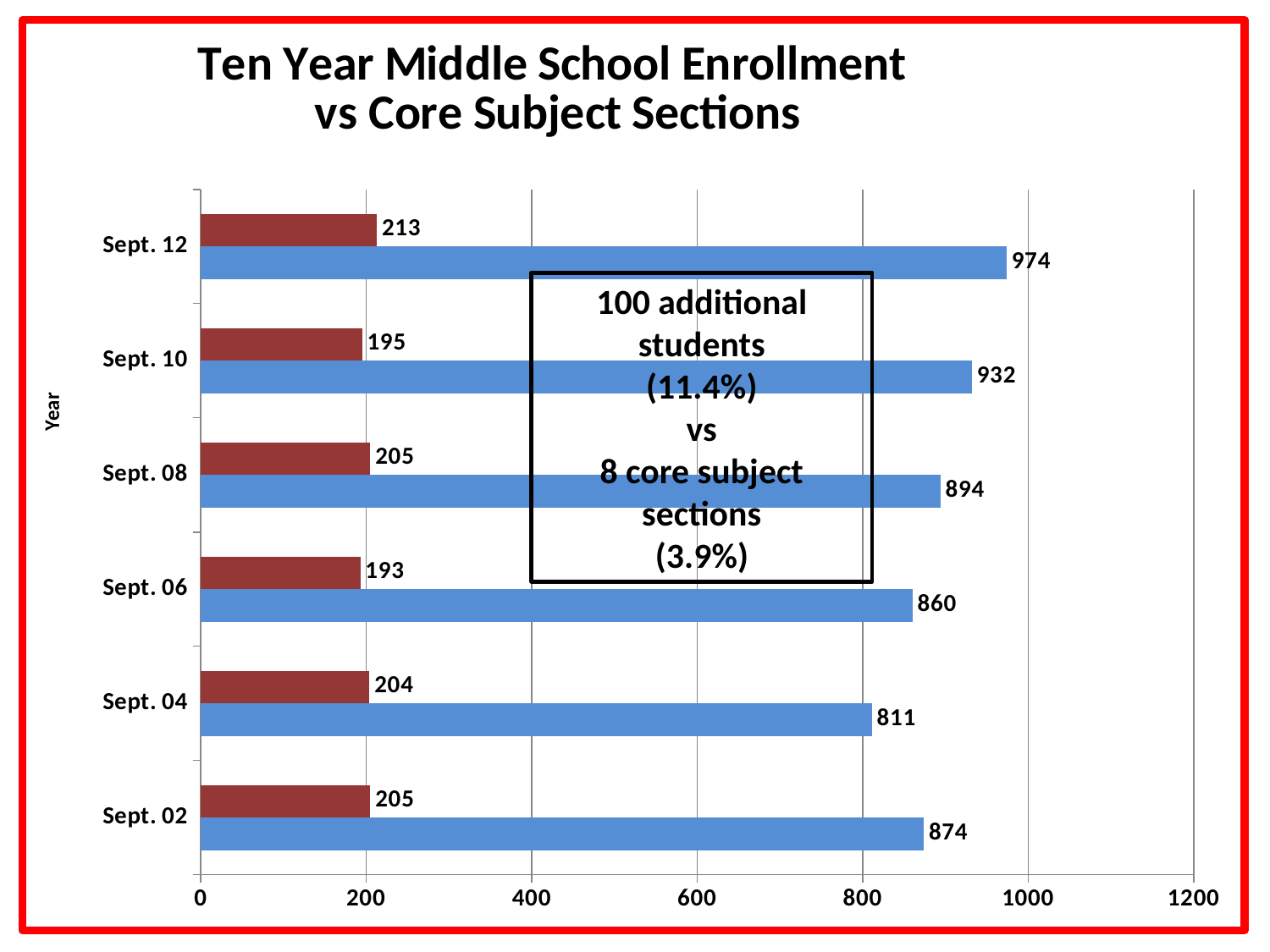
What is the title of the chart? Ten Year Middle School Enrollment vs Core Subject Sections What is the value of the blue bar for Sept. 04? 811 What is the value of the red bar for Sept. 06? 193 How many years are shown on the chart? 6 What is the value of the blue bar for Sept. 12? 974 Which year has the lowest blue bar value? Sept. 04 What is the difference between the blue bar values for Sept. 12 and Sept. 10? 42 Which year has the highest blue bar value? Sept. 12 Is the blue bar value for Sept. 06 greater or less than 800? greater Which year has the lowest red bar value? Sept. 06 What kind of chart is shown on the slide? bar chart Which is larger, the blue bar value for Sept. 08 or for Sept. 02? Sept. 08